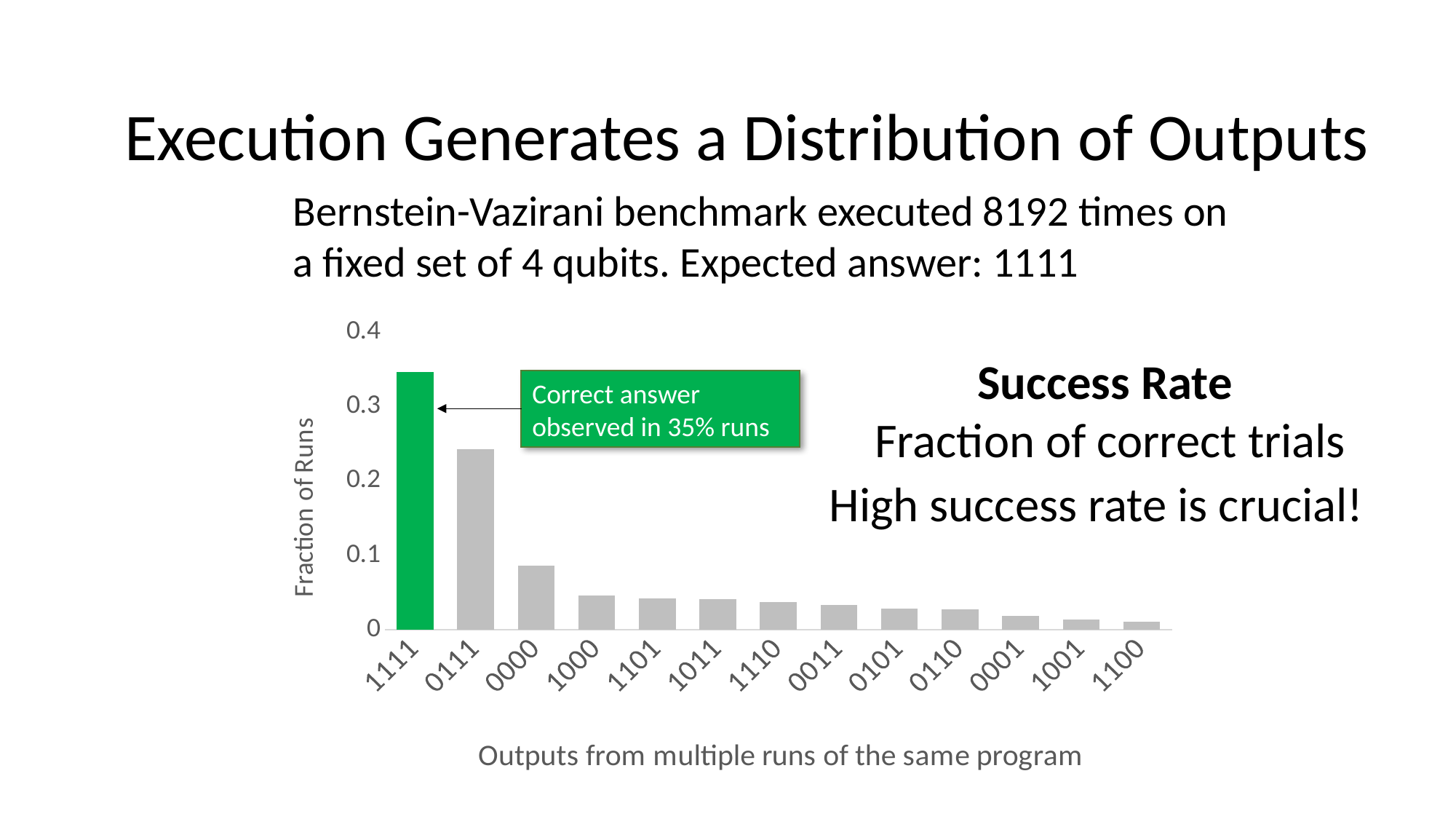
Which output has the highest fraction of runs? 1111 Do the bar values rise or fall moving from left to right along the x axis? fall What colour is the bar for output 1111? green Which output has a larger fraction of runs, 0111 or 0000? 0111 According to the callout on the chart, in what percentage of runs was the correct answer 1111 observed? 35% How many output categories are shown on the x axis of the chart? 13 Is the fraction of runs for output 0111 greater or less than 0.2? greater What is the label of the y axis of the chart? Fraction of Runs Is the fraction of runs for output 0000 greater or less than 0.1? less Which output has the lowest fraction of runs? 1100 Is the fraction of runs for output 1111 greater or less than 0.3? greater What kind of chart is shown on the slide? bar chart